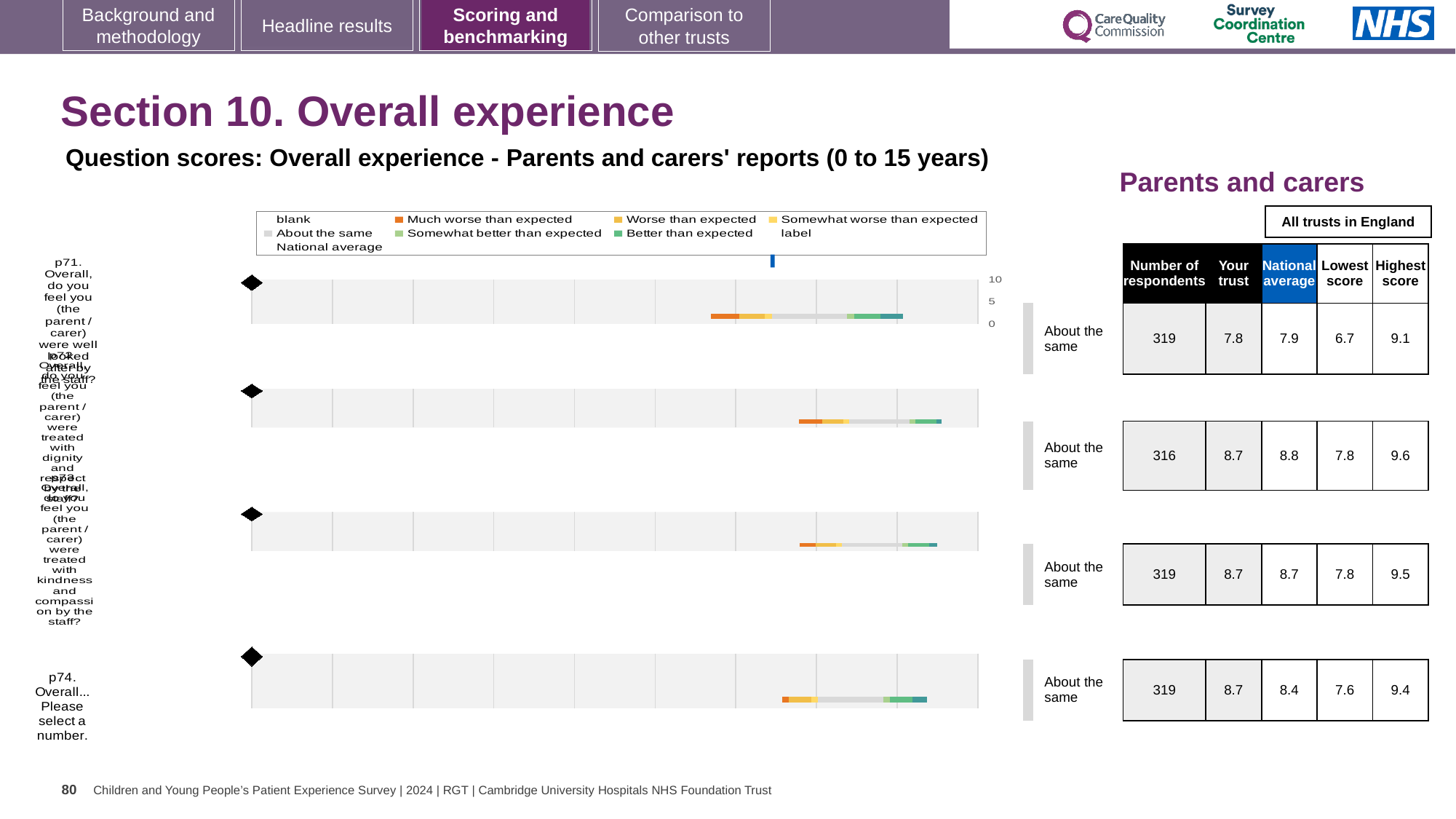
What is the highest tick value shown on the chart's axis? 10 In the table beside the chart, what is the 'National average' for p74 (Overall... Please select a number)? 8.4 What kind of chart is shown on the slide? bar chart What benchmark category is shown next to each bar in the chart? About the same How many question rows (bars) does the chart show? 4 In the table beside the chart, what is the 'Your trust' score for p71 (Overall, do you feel you were well looked after by the staff)? 7.8 In the table beside the chart, what is the number of respondents for p74? 319 In the table beside the chart, what is the 'Highest score' for p74? 9.4 In the table beside the chart, what is the difference between the 'Your trust' score and the 'National average' for p74? 0.3 How many entries does the chart legend list? 9 In the table beside the chart, what is the 'Lowest score' for p71? 6.7 In the table beside the chart, which question row has the lowest 'Your trust' score? p71